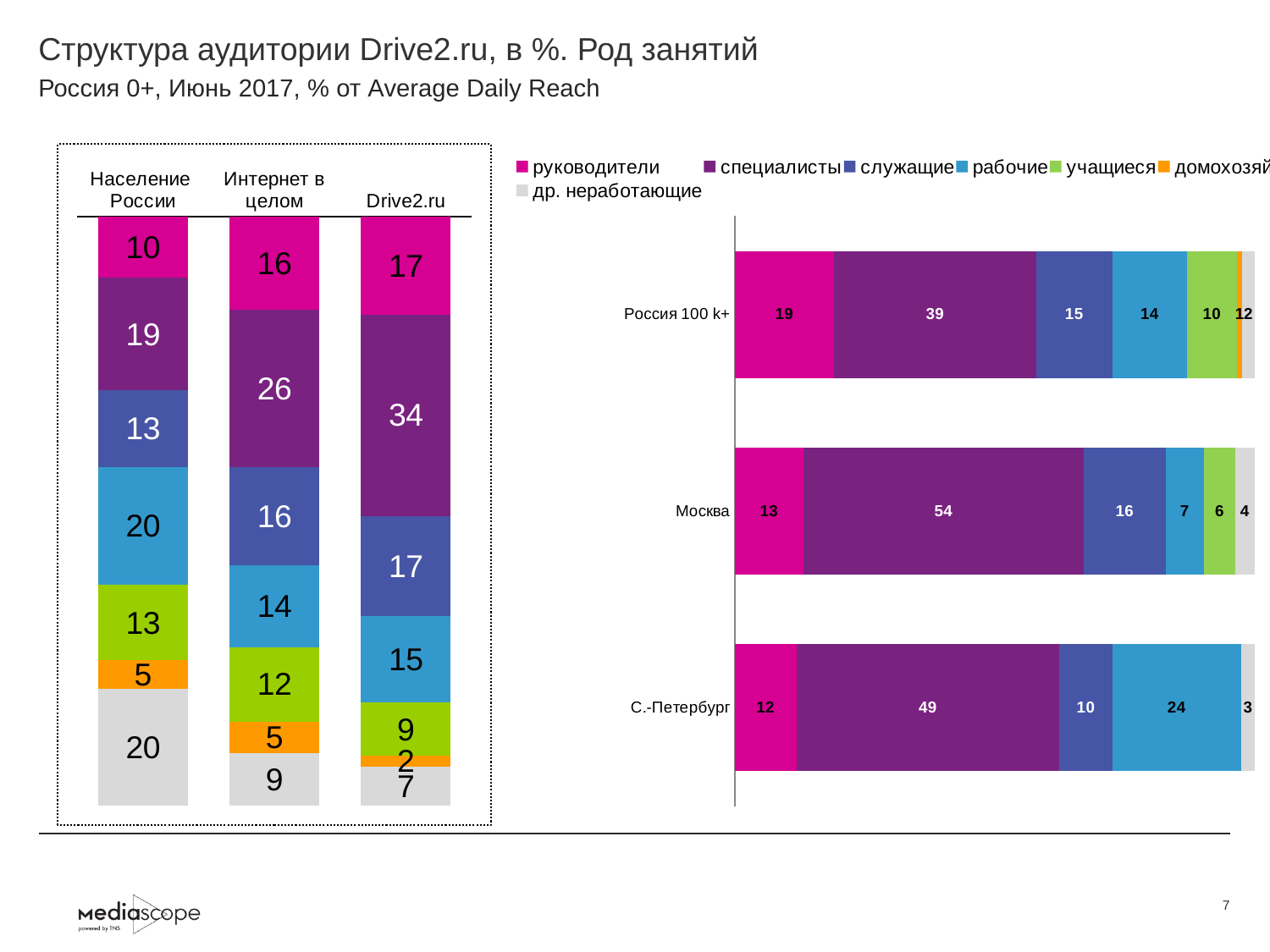
In the right chart, what is the difference between the специалисты value for Москва and for С.-Петербург? 5 In the right chart, which city/region has the highest value for руководители? Россия 100 k+ What kind of chart is the chart on the right? Stacked bar chart In the left chart, what is the value for специалисты in the Drive2.ru column? 34 In the left chart, which is larger: учащиеся for Население России or учащиеся for Drive2.ru? Население России In the left chart, how many columns (audience groups) are shown? 3 In the left chart, what is the difference between the специалисты value for Drive2.ru and for Население России? 15 In the left chart, which occupation group has the largest share in the Drive2.ru column? специалисты In the right chart, what is the value for специалисты for Москва? 54 In the left chart, what is the value for рабочие in the Население России column? 20 How many series does the legend list? 7 In the right chart, what is the value for рабочие for С.-Петербург? 24